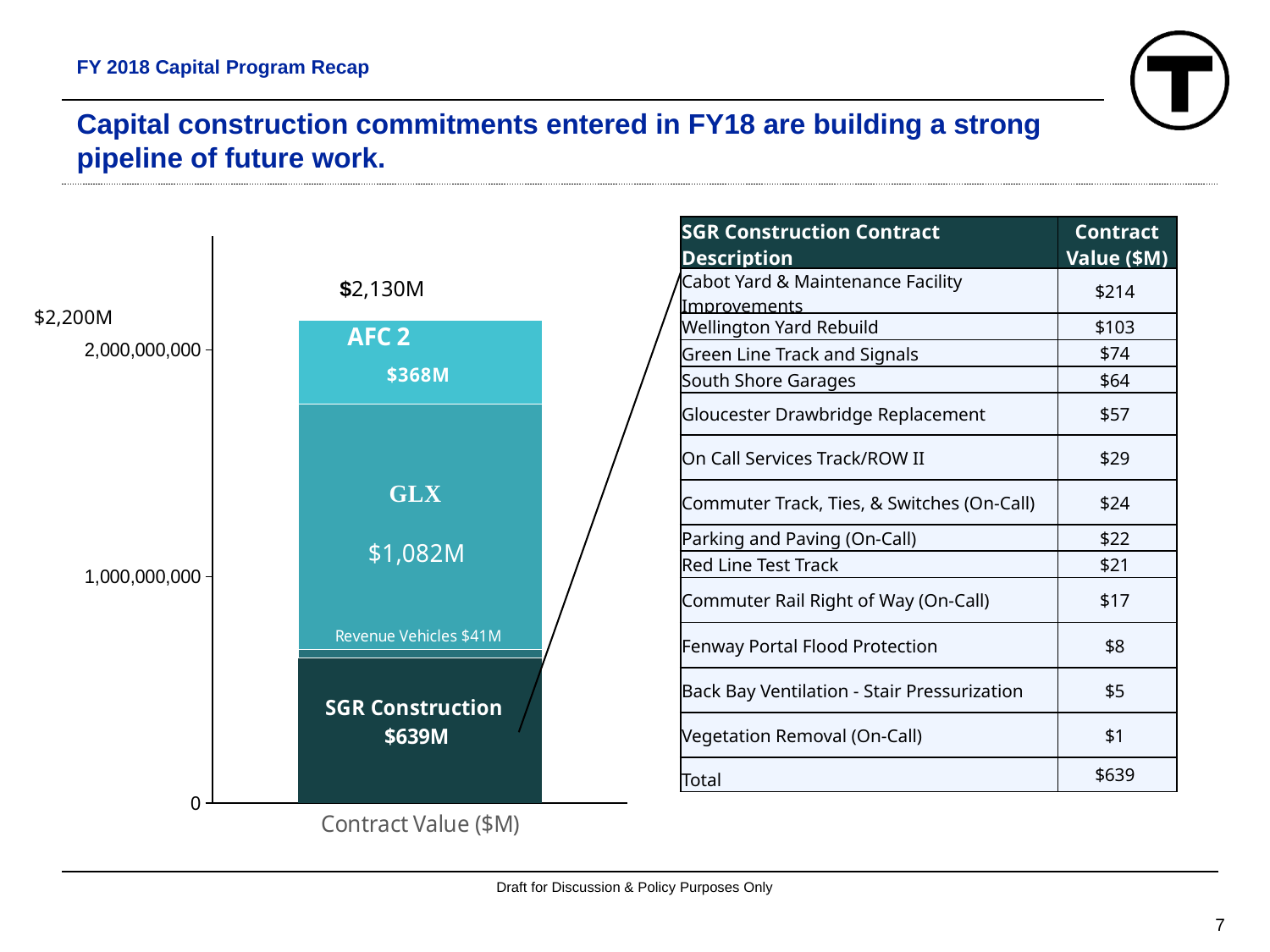
What is the contract value shown for the AFC 2 segment of the stacked bar? $368M Which segment of the stacked bar has the largest contract value? GLX What is the difference between the GLX segment and the SGR Construction segment in the stacked bar? $443M What is the contract value shown for the SGR Construction segment of the stacked bar? $639M What is the total value printed above the stacked bar? $2,130M How many segments make up the stacked bar? 4 What kind of chart is shown on the left of the slide? Stacked bar chart What is the x-axis label of the bar chart? Contract Value ($M) What is the contract value shown for the Revenue Vehicles segment of the stacked bar? $41M Which segment of the stacked bar has the smallest contract value? Revenue Vehicles What is the contract value shown for the GLX segment of the stacked bar? $1,082M Which is larger in the stacked bar, the AFC 2 segment or the SGR Construction segment? SGR Construction